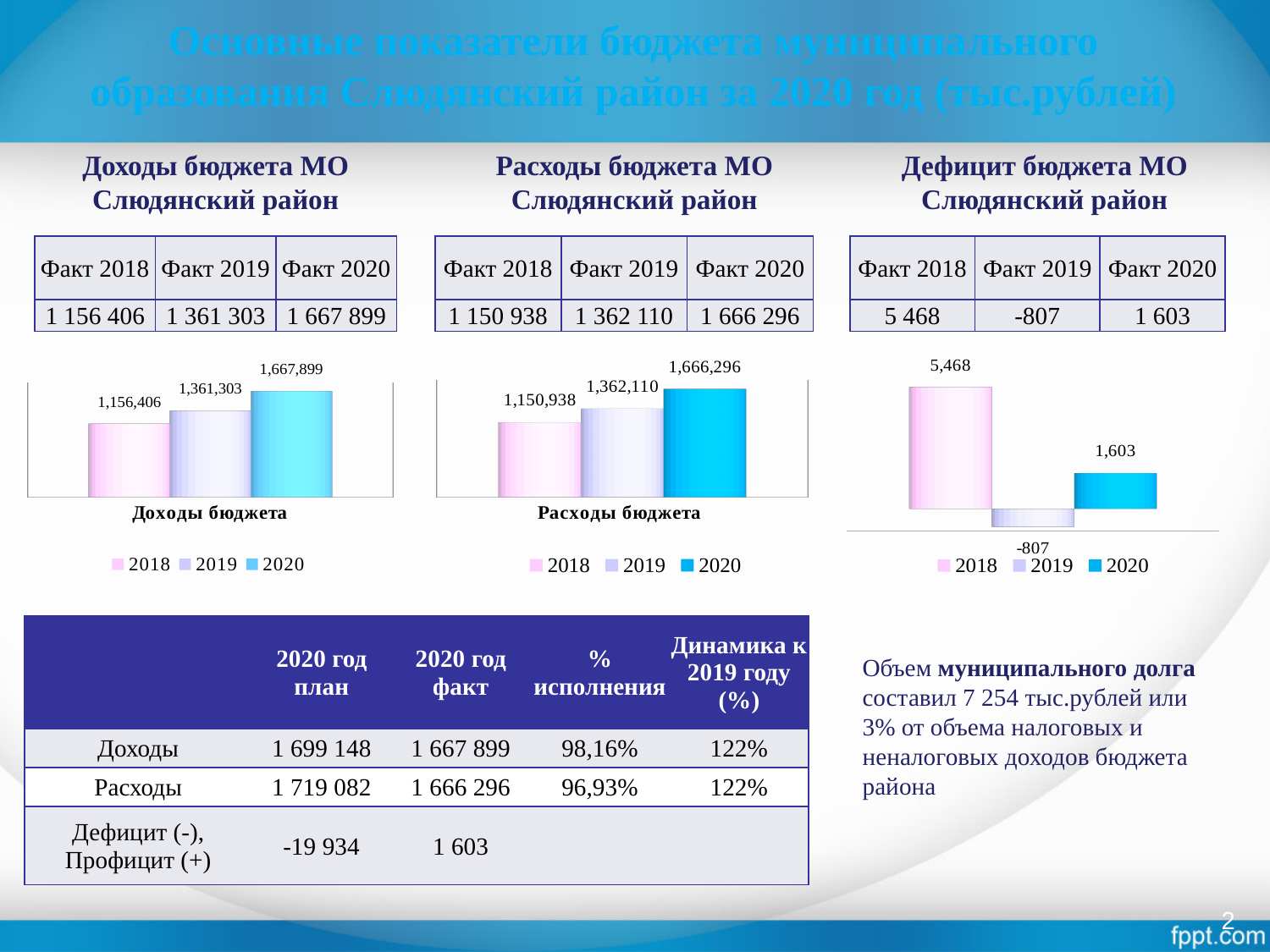
In the 'Расходы бюджета' chart, what is the difference between the 2020 and 2019 values? 304,186 In the 'Расходы бюджета' chart, what is the value for 2019? 1,362,110 What kind of chart is the 'Расходы бюджета' chart? Bar chart In the 'Дефицит бюджета МО Слюдянский район' chart, which year has the lowest value? 2019 In the 'Дефицит бюджета МО Слюдянский район' chart, which is larger, the value for 2018 or the value for 2020? 2018 In the 'Дефицит бюджета МО Слюдянский район' chart, which year has the highest value? 2018 In the 'Доходы бюджета' chart, do the values rise or fall from 2018 to 2020? Rise In the 'Доходы бюджета' chart, what is the value for 2020? 1,667,899 In the 'Дефицит бюджета МО Слюдянский район' chart, what is the value for 2019? -807 In the 'Доходы бюджета' chart, what is the difference between the 2020 and 2019 values? 306,596 In the 'Доходы бюджета' chart, what is the value for 2018? 1,156,406 How many series does the legend of the 'Доходы бюджета' chart list? 3